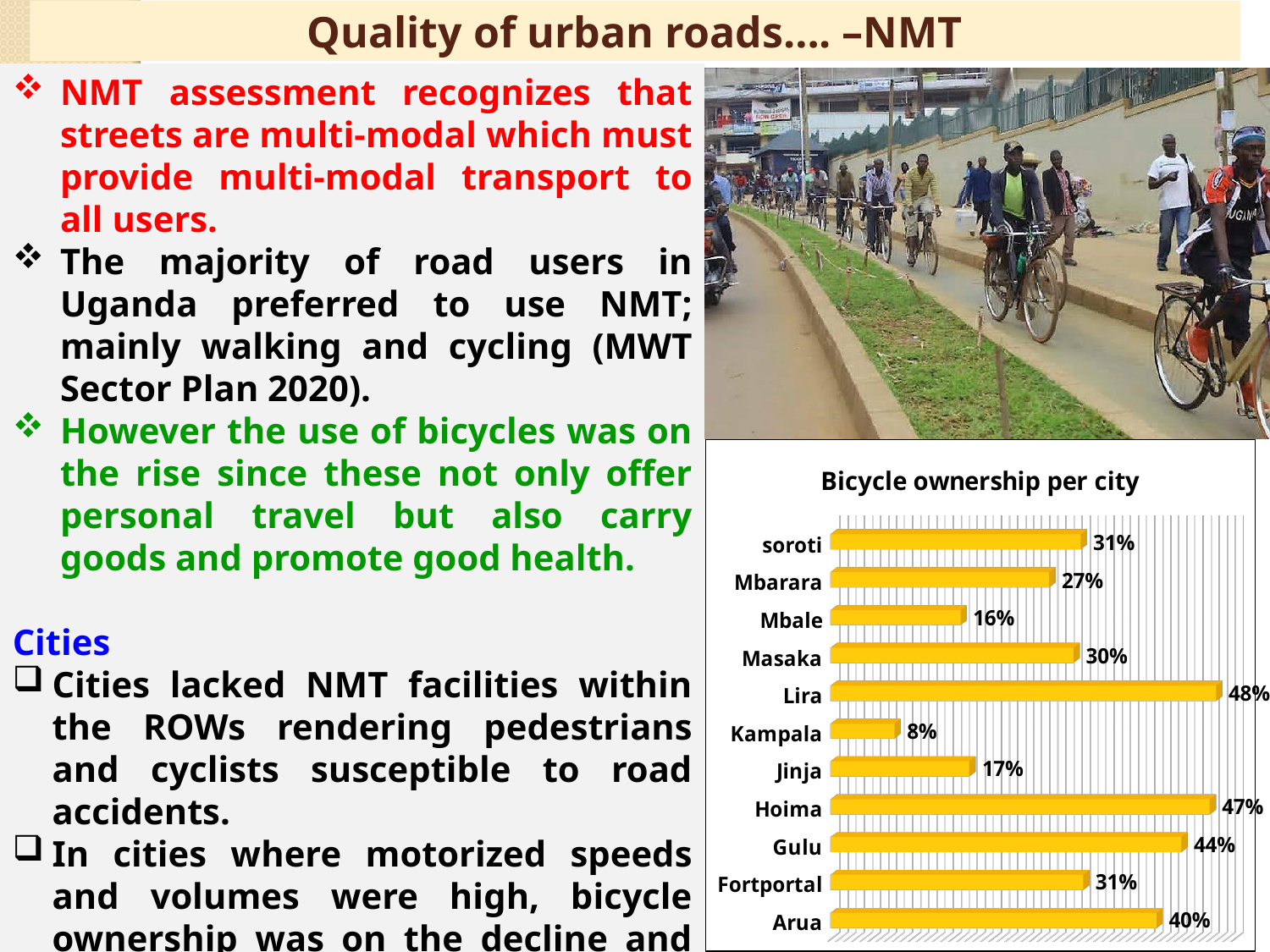
What is the difference in bicycle ownership between Lira and Kampala? 40% What is the bicycle ownership value for Lira? 48% What is the bicycle ownership value for Gulu? 44% What is the title of the chart? Bicycle ownership per city Which has higher bicycle ownership, Arua or Masaka? Arua Which cities share a bicycle ownership value of 31%? soroti and Fortportal How many cities are shown in the chart? 11 What type of chart is used to show bicycle ownership per city? Bar chart Which city has the highest bicycle ownership? Lira Which city has the lowest bicycle ownership? Kampala What is the difference in bicycle ownership between Hoima and Mbale? 31% What is the bicycle ownership value for Kampala? 8%